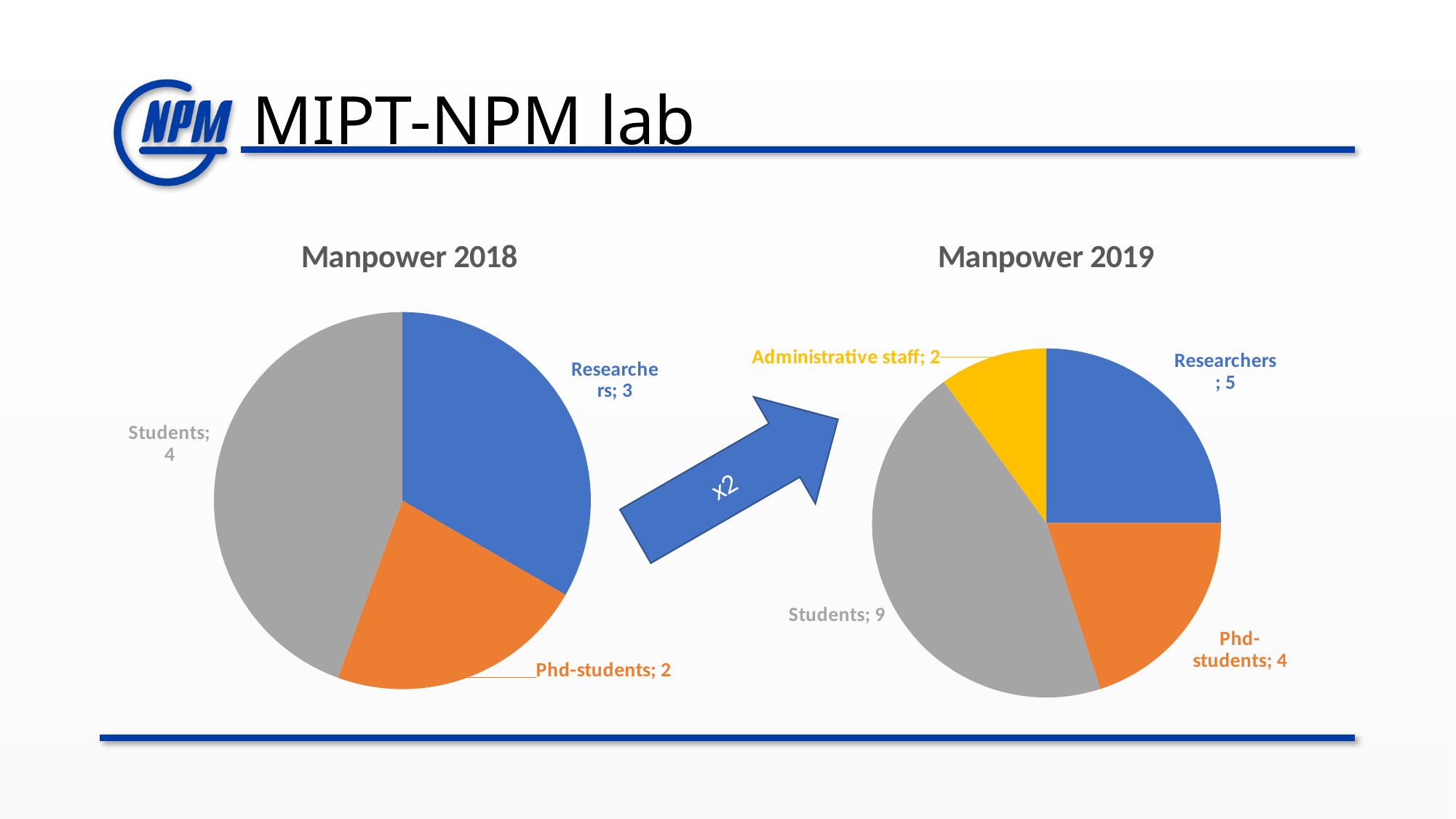
What type of chart is the Manpower 2018 chart? Pie chart In the Manpower 2018 chart, which category has the smallest slice? Phd-students In the Manpower 2018 chart, what is the value for Students? 4 In the Manpower 2019 chart, what colour is the Administrative staff slice? Yellow In the Manpower 2018 chart, which is larger: Researchers or Phd-students? Researchers In the Manpower 2019 chart, what is the difference between the number of Students and the number of Researchers? 4 How many categories does the Manpower 2019 chart show? 4 In the Manpower 2019 chart, how many Administrative staff are shown? 2 In the Manpower 2019 chart, which category has the largest slice? Students In the Manpower 2019 chart, what is the value for Phd-students? 4 In the Manpower 2018 chart, how many Researchers are shown? 3 In the Manpower 2019 chart, what share of the total do Researchers represent? 25%